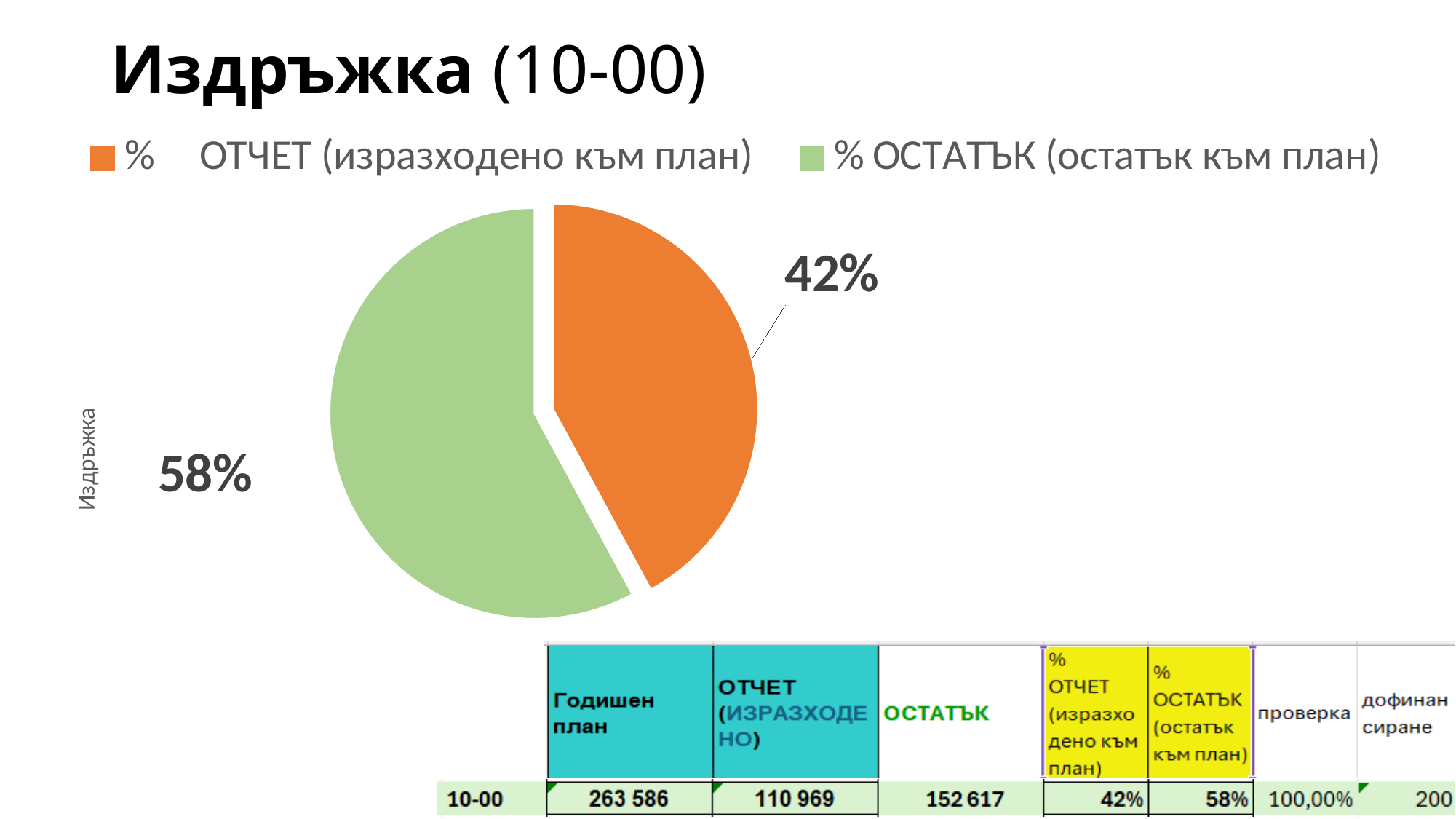
How many entries does the legend list? 2 What is the difference in percentage points between the % ОСТАТЪК slice and the % ОТЧЕТ slice? 16 Which slice of the pie is larger, % ОТЧЕТ or % ОСТАТЪК? % ОСТАТЪК What kind of chart is shown on the slide? pie chart Which slice of the pie is the smallest? % ОТЧЕТ (изразходено към план) Is the share of the % ОСТАТЪК slice greater or less than 50%? greater What share of the pie does the % ОСТАТЪК (остатък към план) slice represent? 58% What share of the pie does the % ОТЧЕТ (изразходено към план) slice represent? 42% What is the title of the slide containing the pie chart? Издръжка (10-00) What colour is the % ОТЧЕТ (изразходено към план) slice? orange Is the share of the % ОТЧЕТ slice greater or less than 50%? less How many slices does the pie chart have? 2